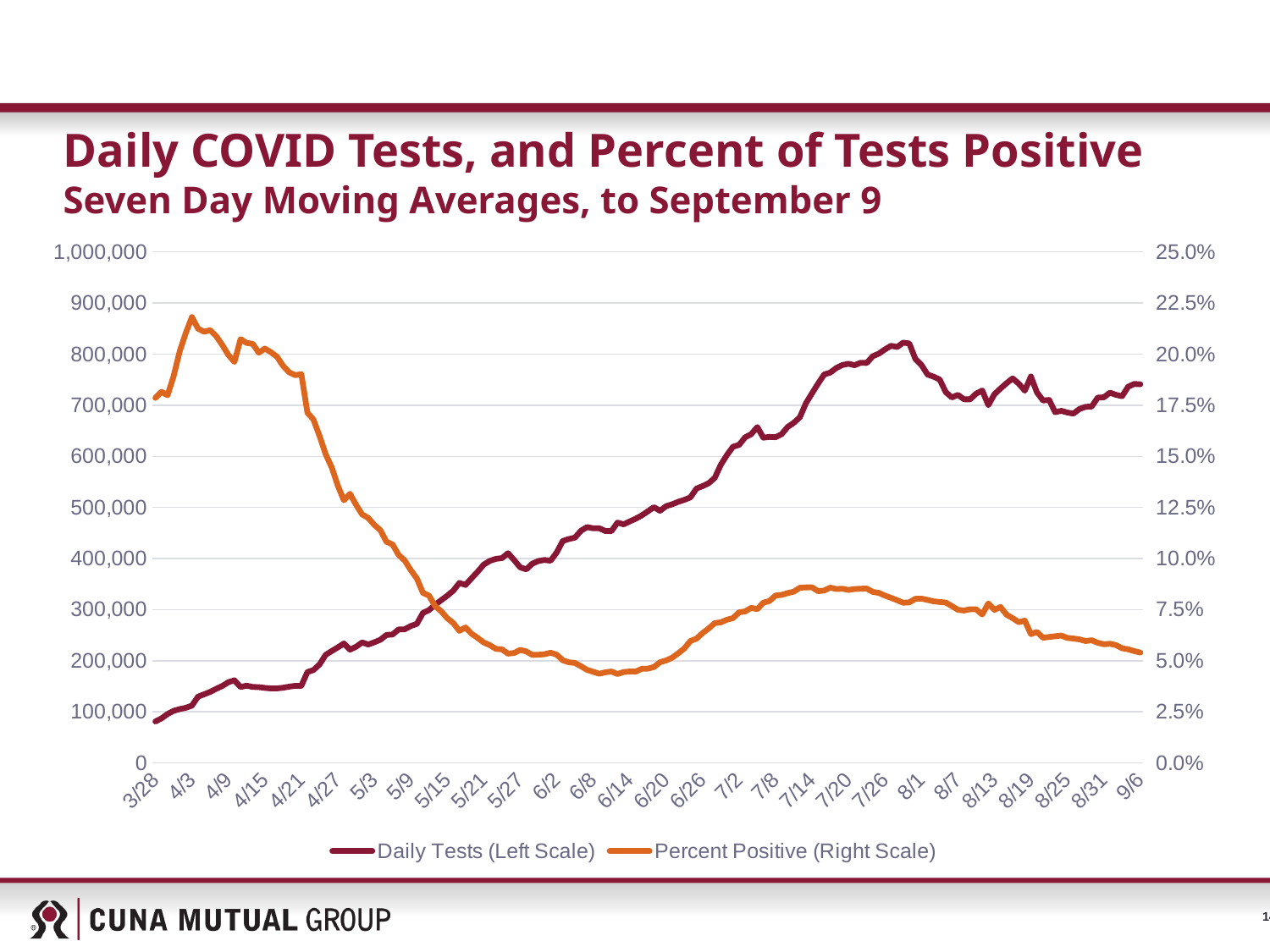
Does the Daily Tests line rise or fall between 3/28 and 7/26? rise Is the value for Percent Positive on 7/20 greater or less than 7.5%? greater What is the highest value shown on the right-hand axis? 25.0% Which is higher: Percent Positive on 4/3 or Percent Positive on 9/6? 4/3 Is the value for Daily Tests on 9/6 greater or less than 700,000? greater Which series is plotted against the right scale? Percent Positive Does the Percent Positive line rise or fall between 4/3 and 6/8? fall What kind of chart is shown on the slide? Line chart Is the value for Percent Positive on 4/3 greater or less than 20.0%? greater How many series does the legend list? 2